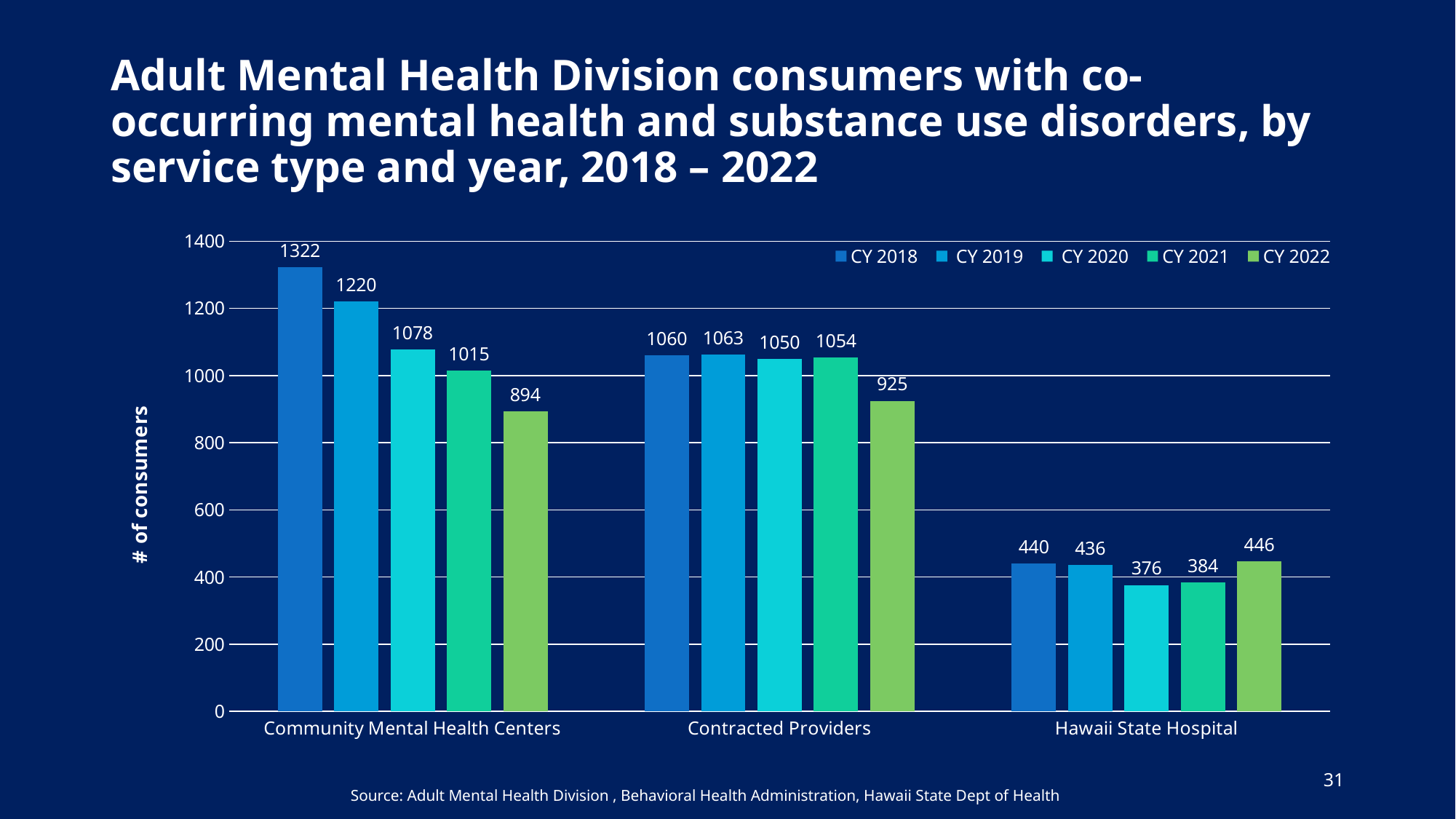
Which service type has the lowest value in CY 2021? Hawaii State Hospital Do the values for Community Mental Health Centers rise or fall from CY 2018 to CY 2022? fall What is the difference between the CY 2018 and CY 2022 values for Community Mental Health Centers? 428 Is the CY 2019 value for Hawaii State Hospital greater or less than 600? less What is the value for Contracted Providers in CY 2020? 1050 How many service type categories are shown on the x axis? 3 What is the value for Hawaii State Hospital in CY 2022? 446 What is the value for Community Mental Health Centers in CY 2018? 1322 What kind of chart is shown on the slide? bar chart Which is larger: the CY 2022 value for Contracted Providers or the CY 2022 value for Community Mental Health Centers? Contracted Providers Which service type has the highest value in CY 2018? Community Mental Health Centers How many series does the legend list? 5